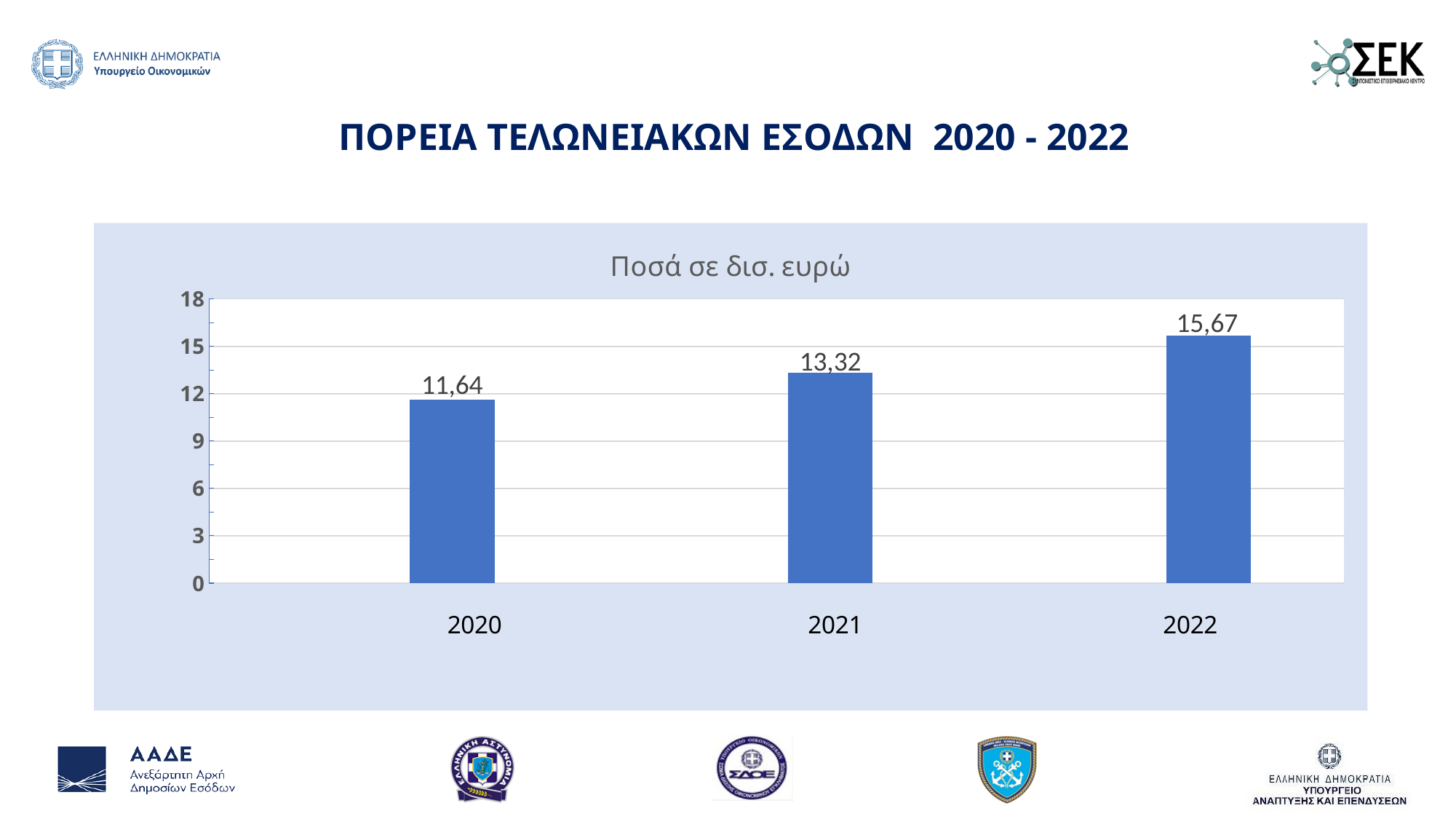
What is the difference between the values for 2021 and 2020? 1,68 Which is larger, the value for 2021 or the value for 2022? 2022 What kind of chart is shown on the slide? bar chart Do the values rise or fall from 2020 to 2022? rise Which year has the lowest value? 2020 What is the value for 2020? 11,64 What is the value for 2021? 13,32 How many years are shown on the x axis? 3 What is the value for 2022? 15,67 Which year has the highest value? 2022 Is the value for 2022 greater or less than 15? greater What is the difference between the values for 2022 and 2020? 4,03